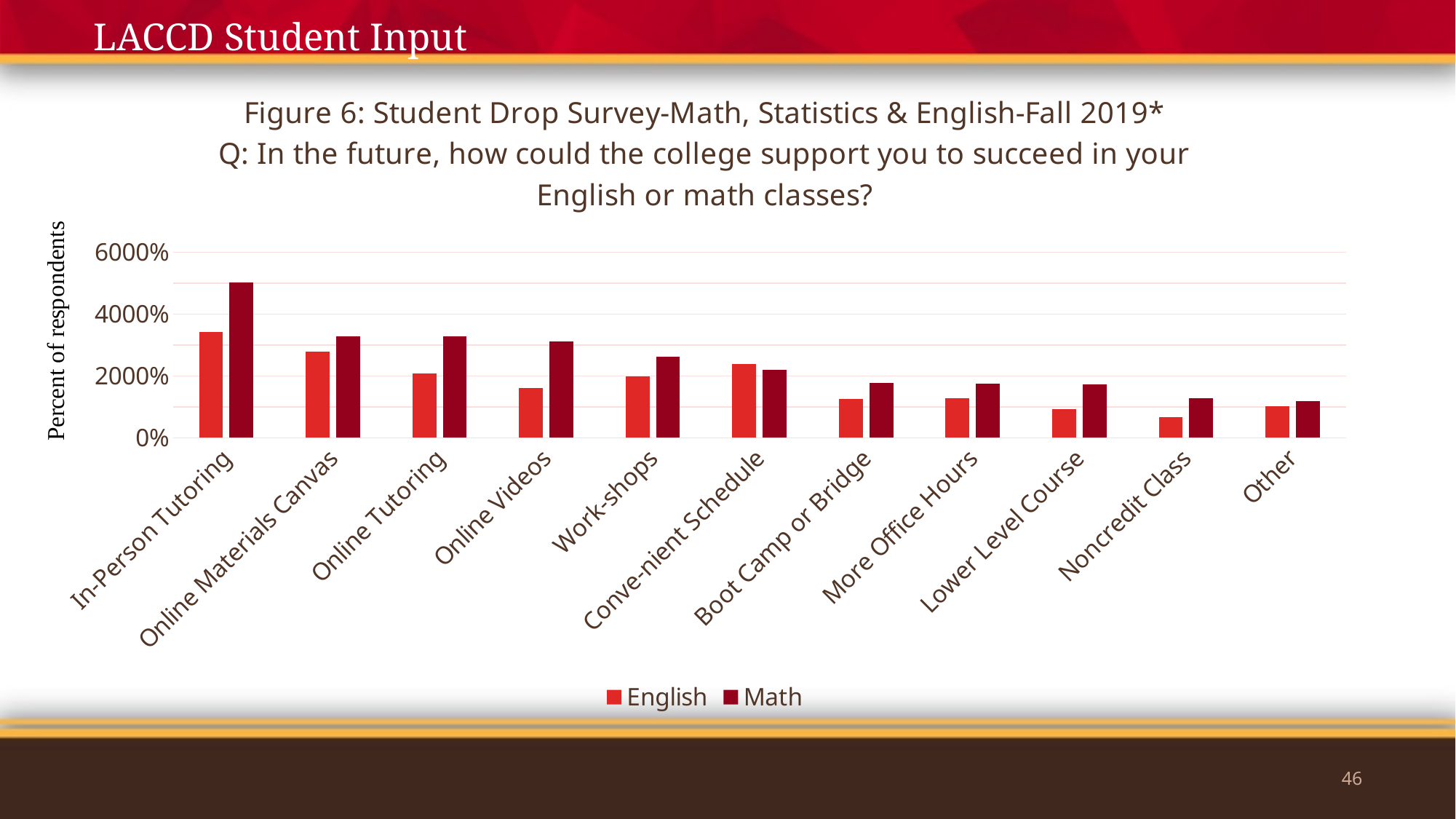
How many categories are shown along the x axis of the chart? 11 Do the Math values generally rise or fall moving from left to right along the x axis? fall What kind of chart is shown on the slide? Bar chart For Online Tutoring, which series has the larger value, English or Math? Math What is the title of the chart's vertical axis? Percent of respondents Which category has the highest English value? In-Person Tutoring Which category has the lowest English value? Noncredit Class Is the Math value for Online Materials Canvas greater or less than 2000%? greater Is the Math value for In-Person Tutoring greater or less than 4000%? greater Is the English value for Online Videos greater or less than 2000%? less Which category has the highest Math value? In-Person Tutoring How many series does the chart's legend list? 2